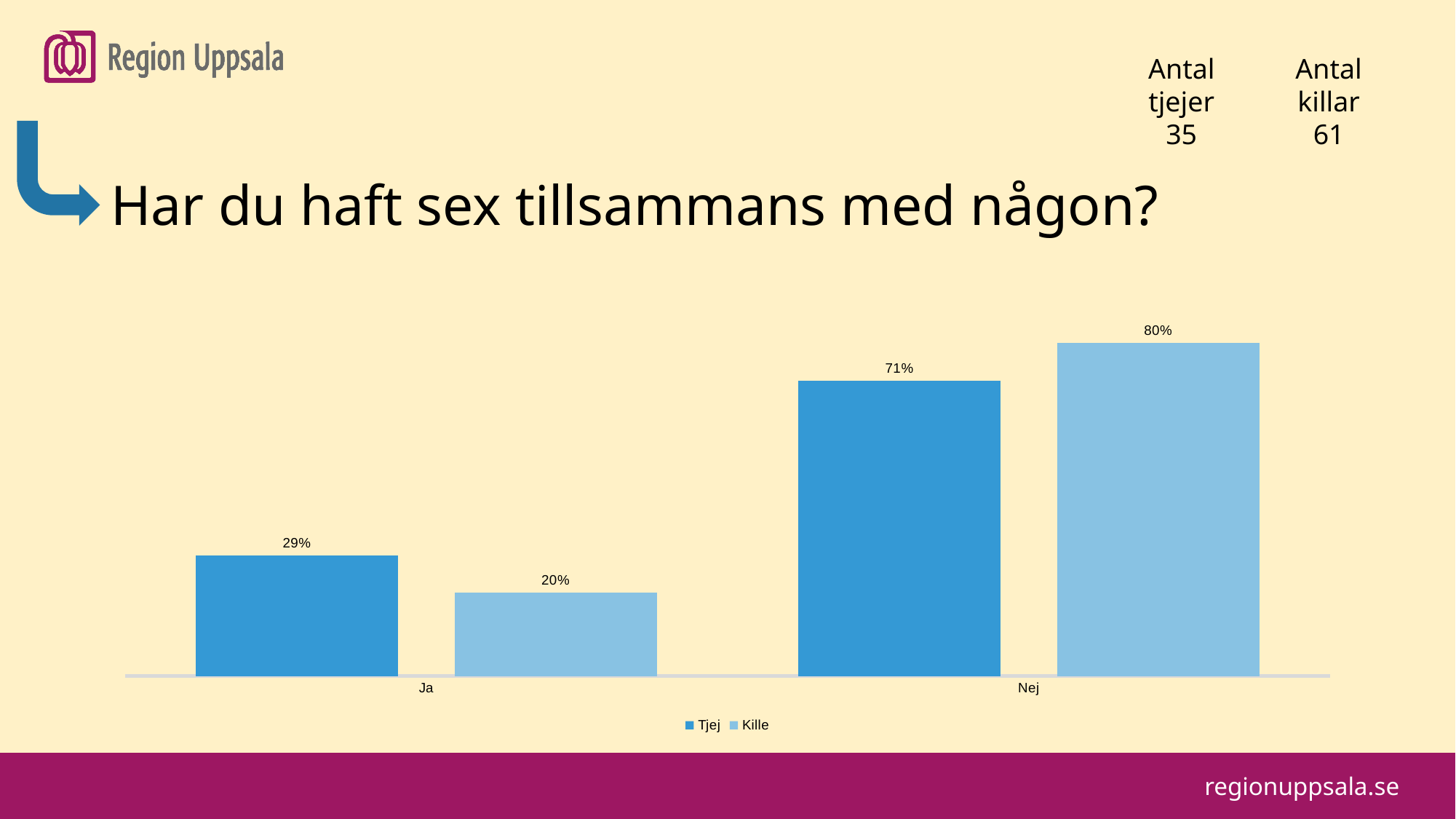
Which bar has the lowest value on the chart? Kille, Ja How many categories are shown on the x axis? 2 Which bar has the highest value on the chart? Kille, Nej What is the difference between the Tjej and Kille values in the Ja category? 9% What is the value for Tjej in the Ja category? 29% Which is larger in the Ja category, Tjej or Kille? Tjej What is the value for Kille in the Nej category? 80% How many series does the legend list? 2 What is the value for Tjej in the Nej category? 71% What is the value for Kille in the Ja category? 20% What is the difference between the Kille and Tjej values in the Nej category? 9% What kind of chart is shown on the slide? Bar chart